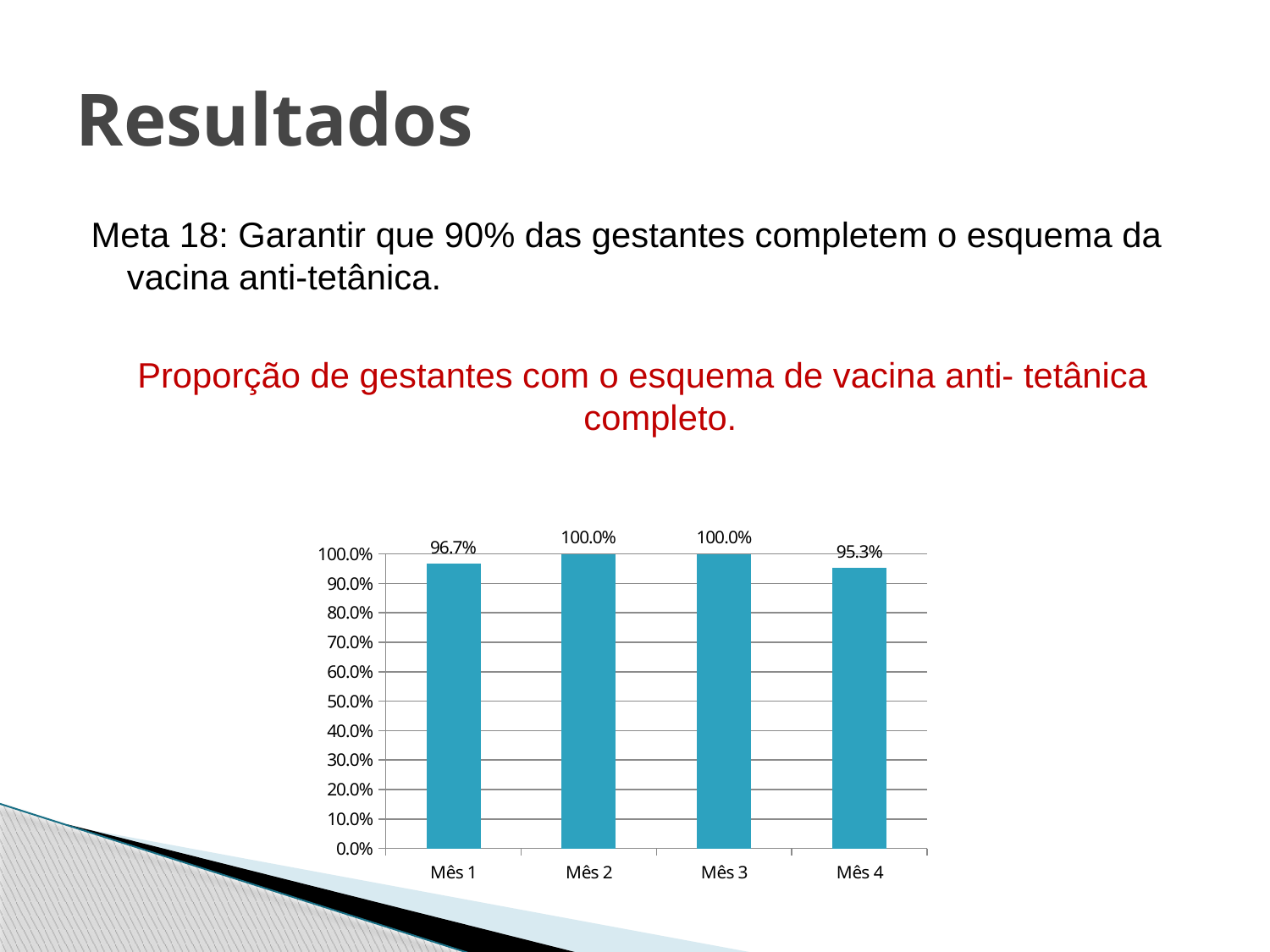
How many months are shown on the x axis? 4 Which month has the lowest value? Mês 4 What is the highest tick value shown on the y axis? 100.0% What is the value for Mês 4? 95.3% Is the value for Mês 4 greater or less than 90.0%? greater What is the difference between the values for Mês 2 and Mês 4? 4.7% What kind of chart is shown on the slide? bar chart What is the difference between the values for Mês 1 and Mês 4? 1.4% What is the value for Mês 1? 96.7% What is the value for Mês 2? 100.0% Do the values rise or fall from Mês 3 to Mês 4? fall Which is larger, the value for Mês 1 or the value for Mês 4? Mês 1